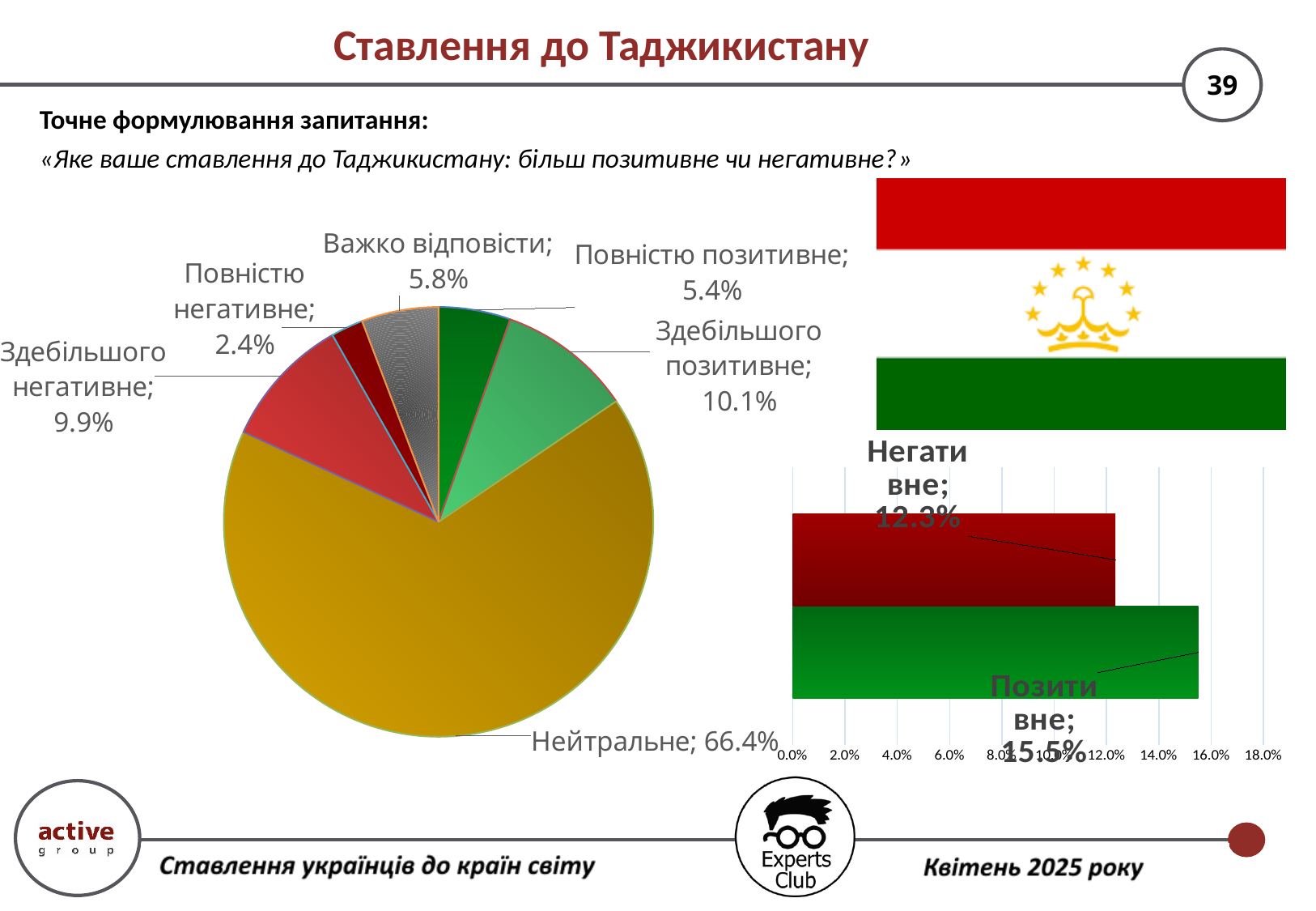
What type of chart is shown on the right side of the slide below the flag? Bar chart In the pie chart, which category has the largest slice? Нейтральне In the pie chart, what share is labelled "Нейтральне"? 66.4% In the bar chart on the right, what is the difference between "Позитивне" and "Негативне"? 3.2% In the bar chart on the right, what is the value for "Негативне"? 12.3% In the pie chart, which category has the smallest slice? Повністю негативне In the pie chart, what is the value for "Повністю негативне"? 2.4% In the pie chart, what is the value for "Здебільшого позитивне"? 10.1% In the pie chart, which is larger: "Важко відповісти" or "Повністю позитивне"? Важко відповісти In the bar chart on the right, what is the value for "Позитивне"? 15.5% In the pie chart, how many slices are there? 6 In the pie chart, what is the difference between "Здебільшого позитивне" and "Здебільшого негативне"? 0.2%